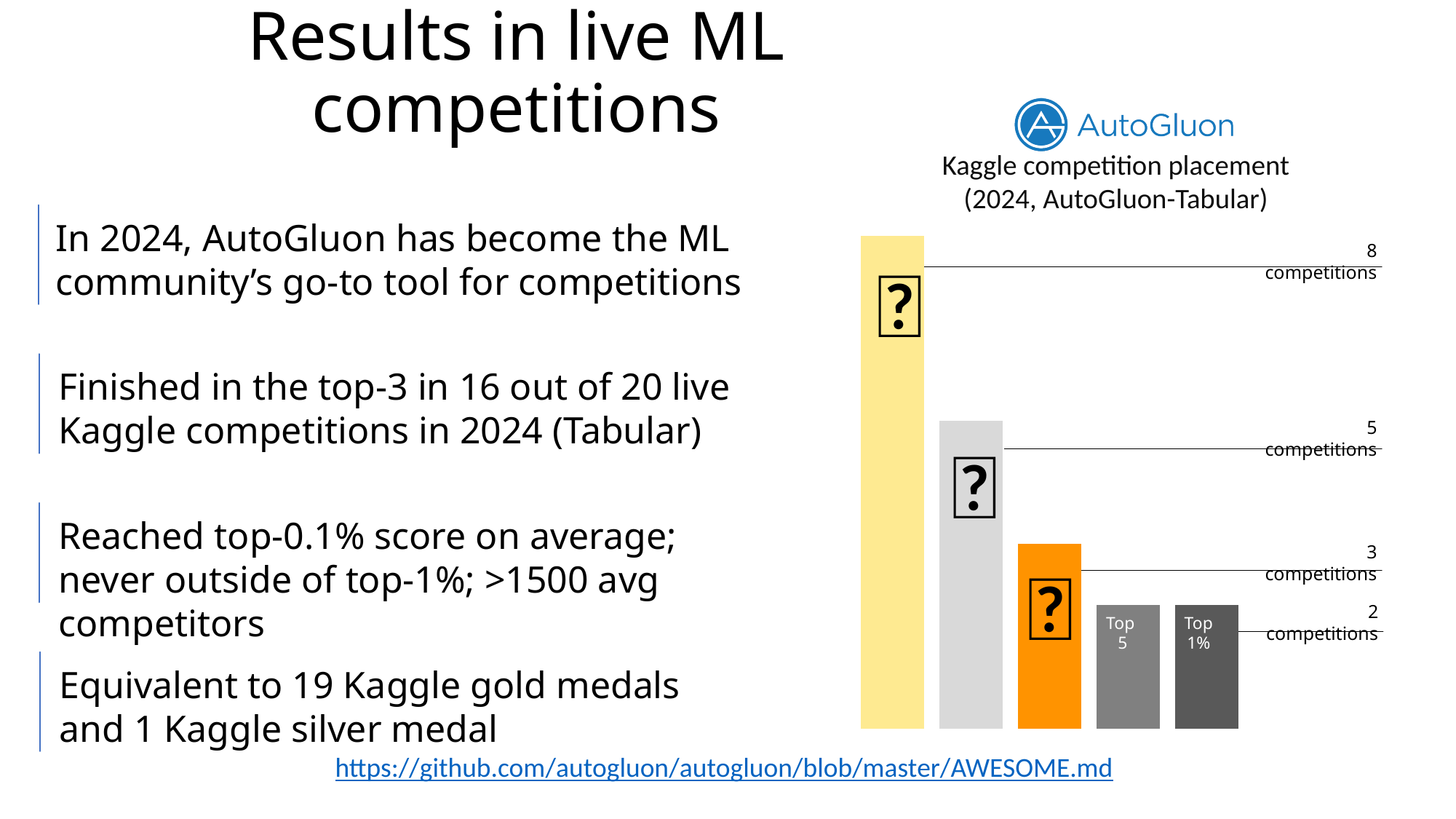
What is the title of the chart on the slide? Kaggle competition placement (2024, AutoGluon-Tabular) How many competitions does the second (light gray) bar represent? 5 competitions What kind of chart is shown on the slide? bar chart Which bar is the tallest in the chart? the leftmost yellow bar (labelled '?') How many competitions does the orange bar represent? 3 competitions How many competitions does the 'Top 5' bar represent? 2 competitions What is the difference in competitions between the tallest bar and the second bar? 3 competitions Do the bar values rise or fall from left to right across the chart? fall How many competitions does the tallest (yellow, leftmost) bar represent? 8 competitions How many competitions does the 'Top 1%' bar represent? 2 competitions How many bars does the chart show? 5 Which is larger, the orange bar or the 'Top 5' bar? the orange bar